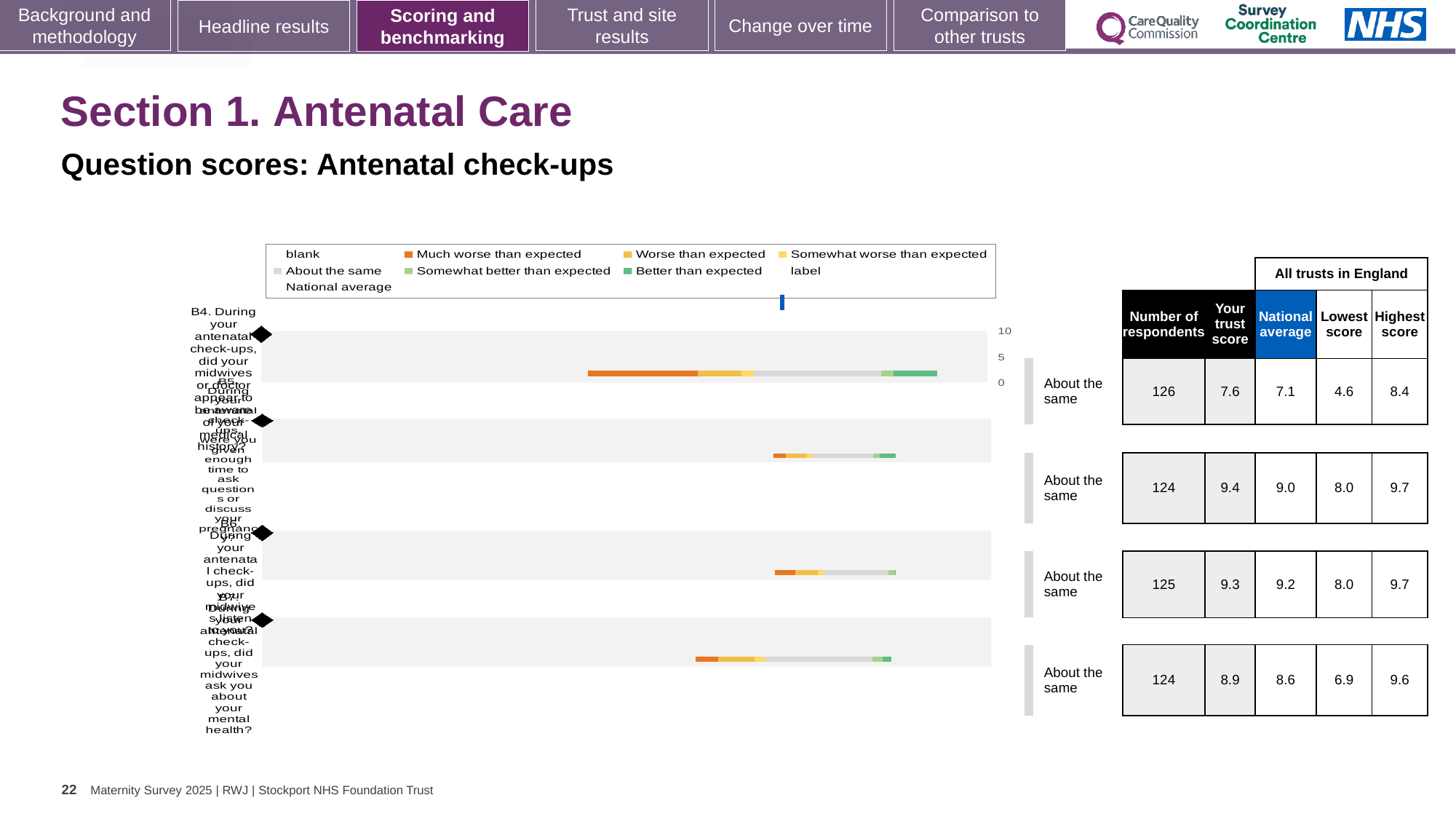
Which of the four questions has the lowest trust score? B4 (7.6) What is the national average for question B4 (the top bar)? 7.1 What is the trust score for question B4 (the top bar), as shown in the table? 7.6 What colour represents 'Better than expected' in the chart legend? green For the bottom question (B7), which is larger: the trust score or the national average? trust score (8.9) What kind of chart is shown on the slide? bar chart How many respondents answered question B4 (the top bar)? 126 What is the highest score among all trusts in England for the top question (B4)? 8.4 What colour represents 'Much worse than expected' in the chart legend? orange What is the difference between the trust score and the national average for question B4 (the top bar)? 0.5 Which of the four questions has the highest trust score? the second question (9.4) How many questions (bars) are plotted in the chart? 4